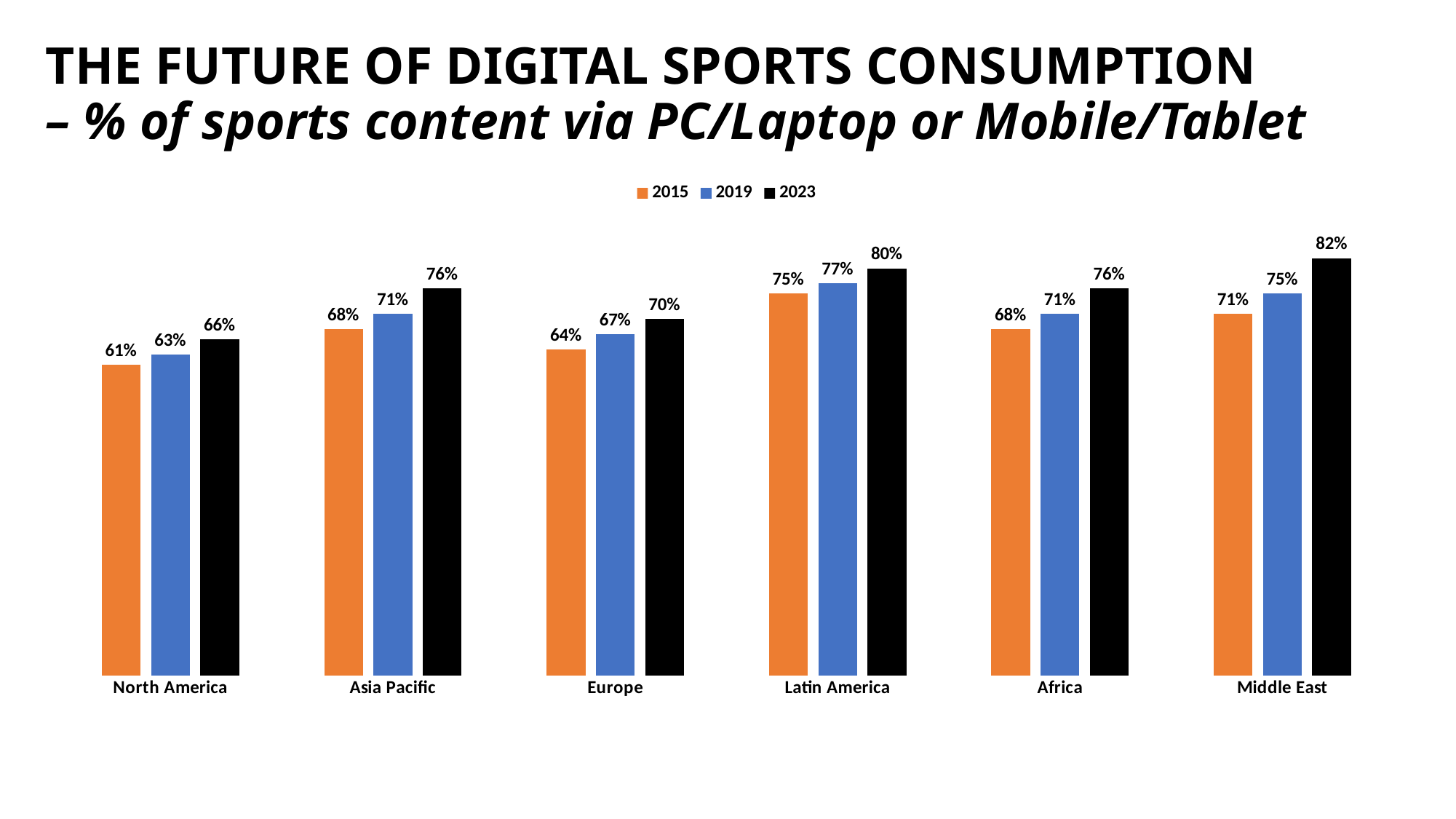
What is the 2019 value for Latin America? 77% How many regions are shown on the x axis? 6 What is the difference between the 2023 and 2015 values for Asia Pacific? 8% How many series does the legend list? 3 Which colour represents the 2019 series in the legend? Blue What is the 2023 value for Middle East? 82% Which region has the highest 2023 value? Middle East For North America, do the values rise or fall from 2015 to 2023? Rise Which region has the lowest 2015 value? North America Which is larger, the 2019 value for Africa or the 2019 value for Europe? Africa What is the 2015 value for Europe? 64% What kind of chart is shown on the slide? Bar chart